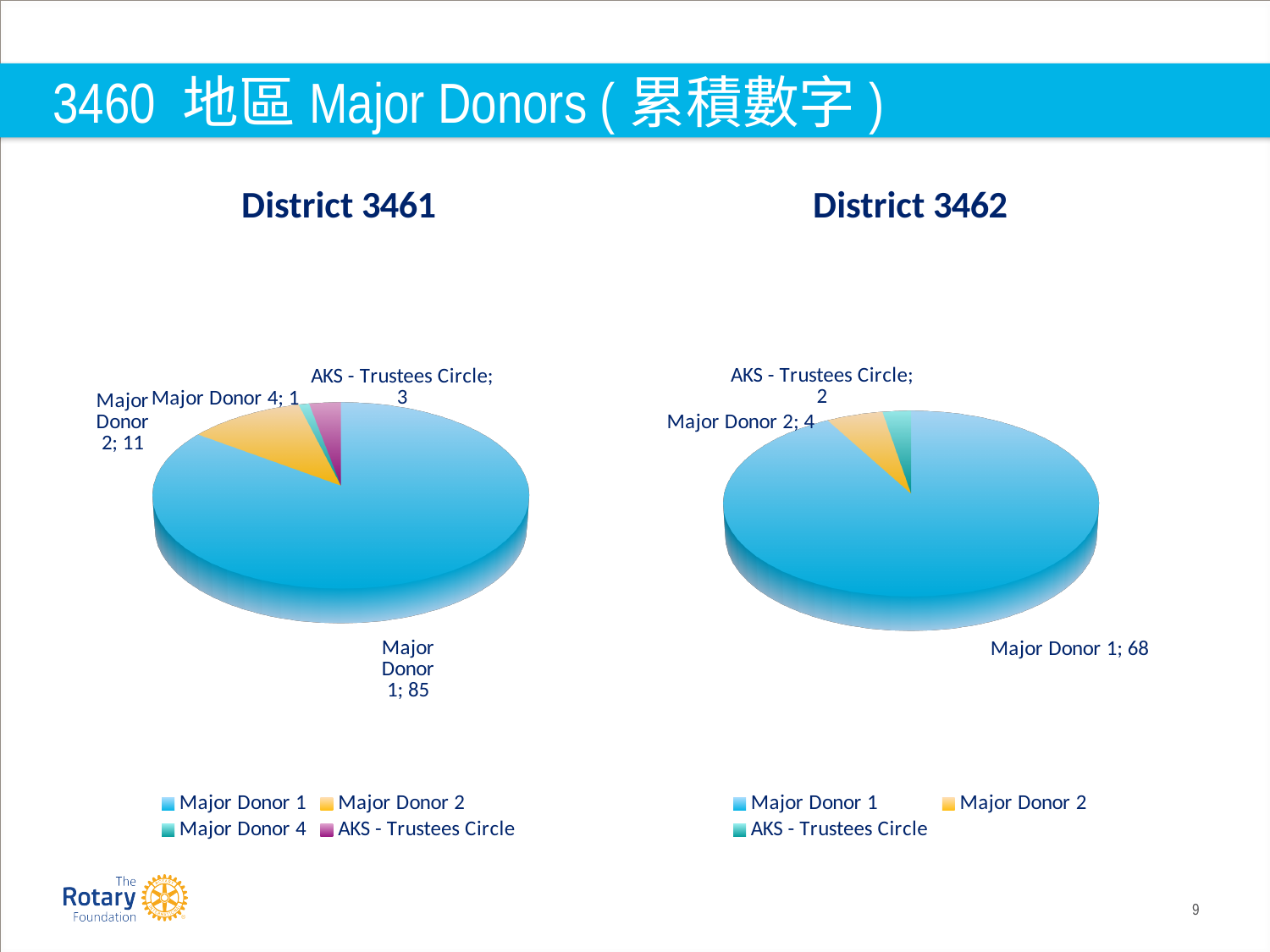
In the District 3462 chart, what is the total of all slices? 74 In the District 3461 chart, which category has the smallest slice? Major Donor 4 In the District 3461 chart, what is the difference between Major Donor 1 and Major Donor 2? 74 What type of chart is used for District 3462? Pie chart In the District 3461 chart, what is the value for AKS - Trustees Circle? 3 In the District 3461 chart, what is the value for Major Donor 1? 85 Which is larger: Major Donor 2 in District 3461 or Major Donor 2 in District 3462? District 3461 In the District 3462 chart, what is the value for Major Donor 2? 4 In the District 3462 chart, which category has the largest slice? Major Donor 1 How many categories does the District 3461 chart show? 4 In the District 3461 chart, what share of the total does Major Donor 1 represent? 85% How many categories does the District 3462 chart show? 3